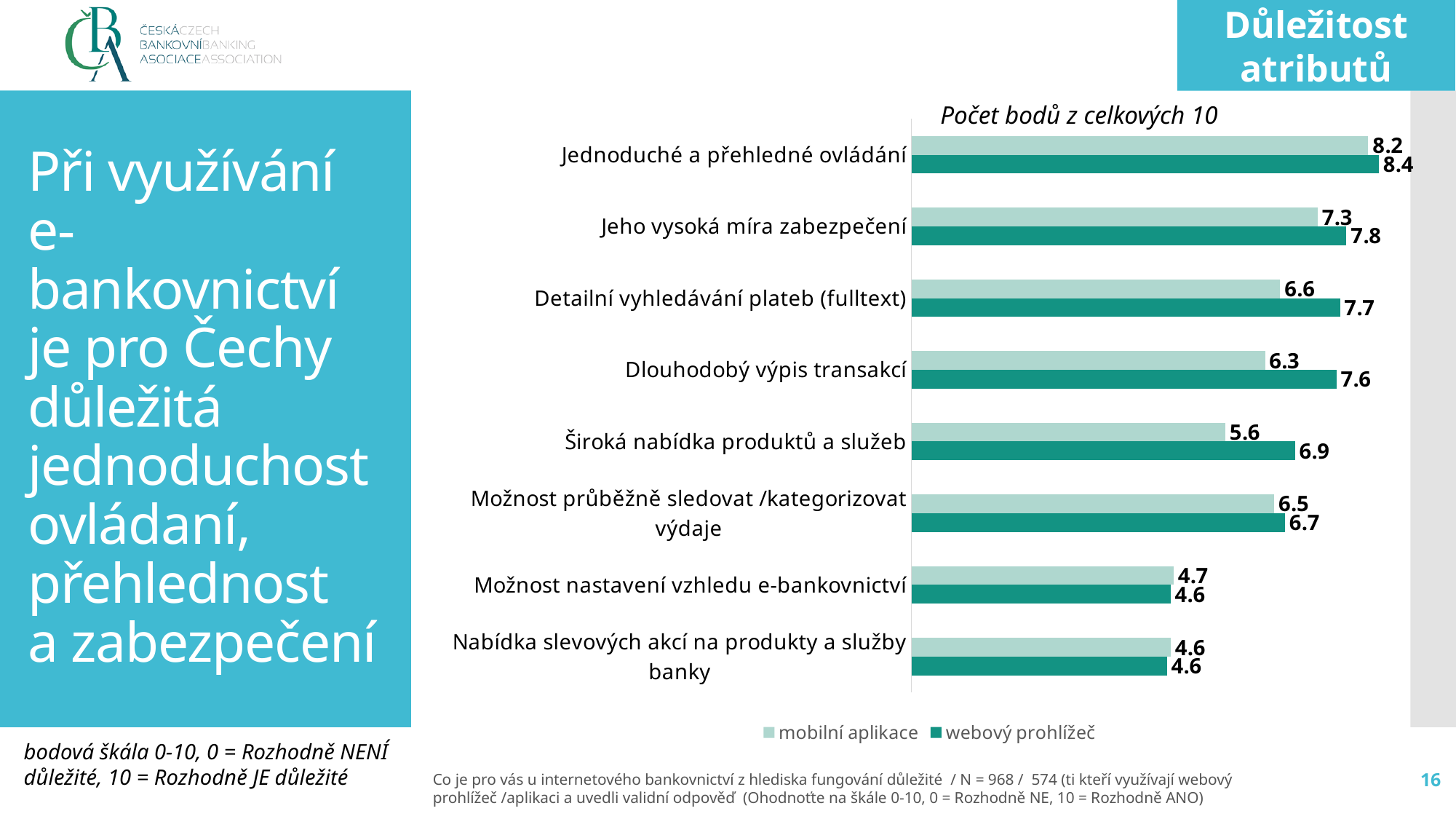
What kind of chart is shown on the slide? bar chart What is the title shown above the chart? Počet bodů z celkových 10 What is the value for "webový prohlížeč" for "Dlouhodobý výpis transakcí"? 7.6 What is the value for "mobilní aplikace" for "Jednoduché a přehledné ovládání"? 8.2 What is the value for "mobilní aplikace" for "Široká nabídka produktů a služeb"? 5.6 What is the difference between the "webový prohlížeč" and "mobilní aplikace" values for "Široká nabídka produktů a služeb"? 1.3 Which category has the highest value for "webový prohlížeč"? Jednoduché a přehledné ovládání For "Jeho vysoká míra zabezpečení", which series has the larger value: "mobilní aplikace" or "webový prohlížeč"? webový prohlížeč How many categories are shown in the chart? 8 What is the difference between the "webový prohlížeč" and "mobilní aplikace" values for "Detailní vyhledávání plateb (fulltext)"? 1.1 Which category has the lowest value for "mobilní aplikace"? Nabídka slevových akcí na produkty a služby banky How many series does the legend list? 2